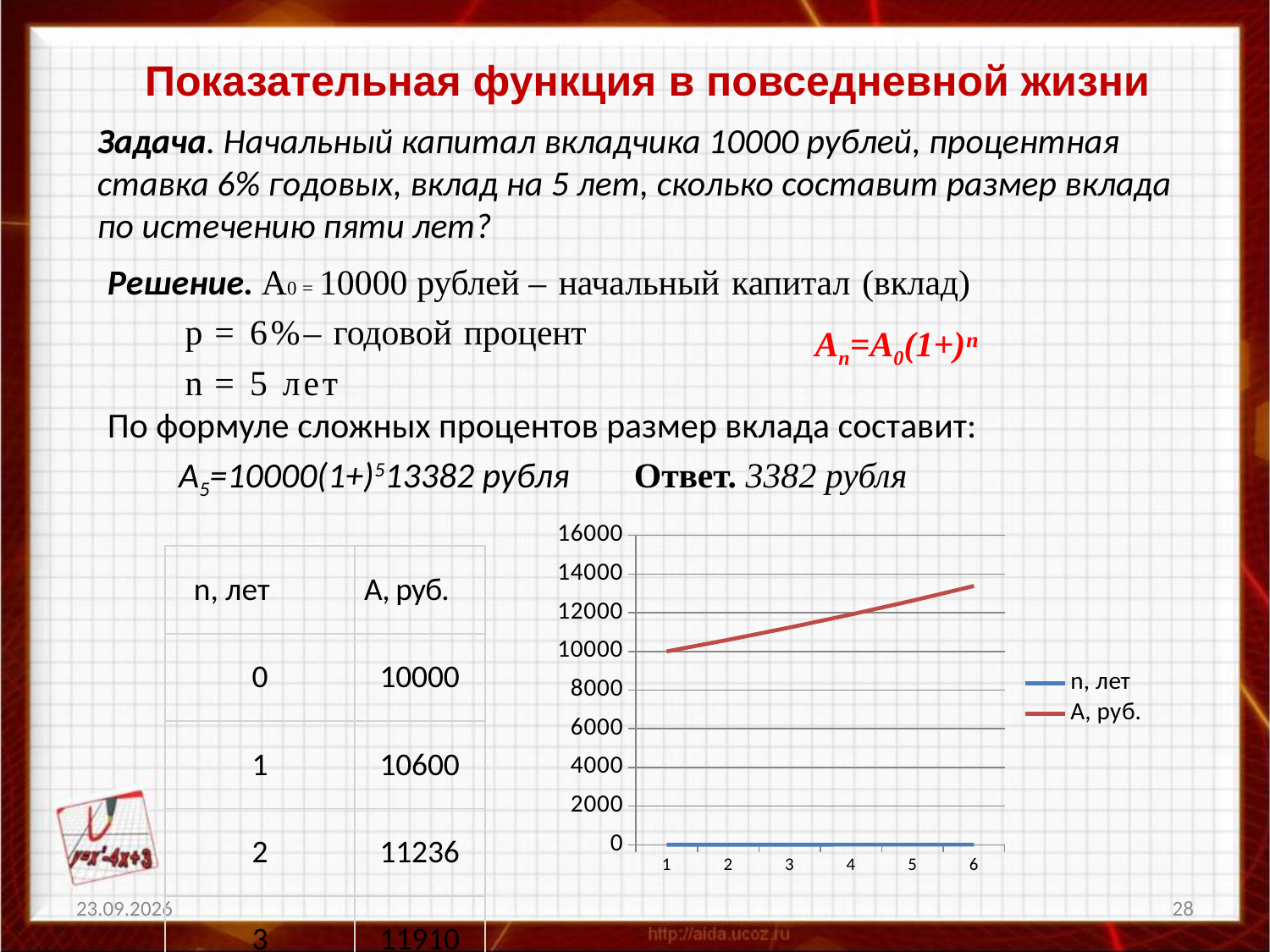
Is the value of the "A, руб." series at x = 6 greater or less than 14000? less Is the value of the "n, лет" series at x = 6 greater or less than 2000? less What are the two series named in the chart legend? n, лет and A, руб. What is the value of the "A, руб." series at x = 1? 10000 Which series has the higher value at x = 6, "n, лет" or "A, руб."? A, руб. What kind of chart is shown on the slide? line chart Is the value of the "A, руб." series at x = 6 greater or less than 12000? greater How many points are labelled along the x axis of the chart? 6 What colour is the "A, руб." line in the chart? red How many series does the chart legend list? 2 Does the "A, руб." line rise or fall as you move along the x axis? rise